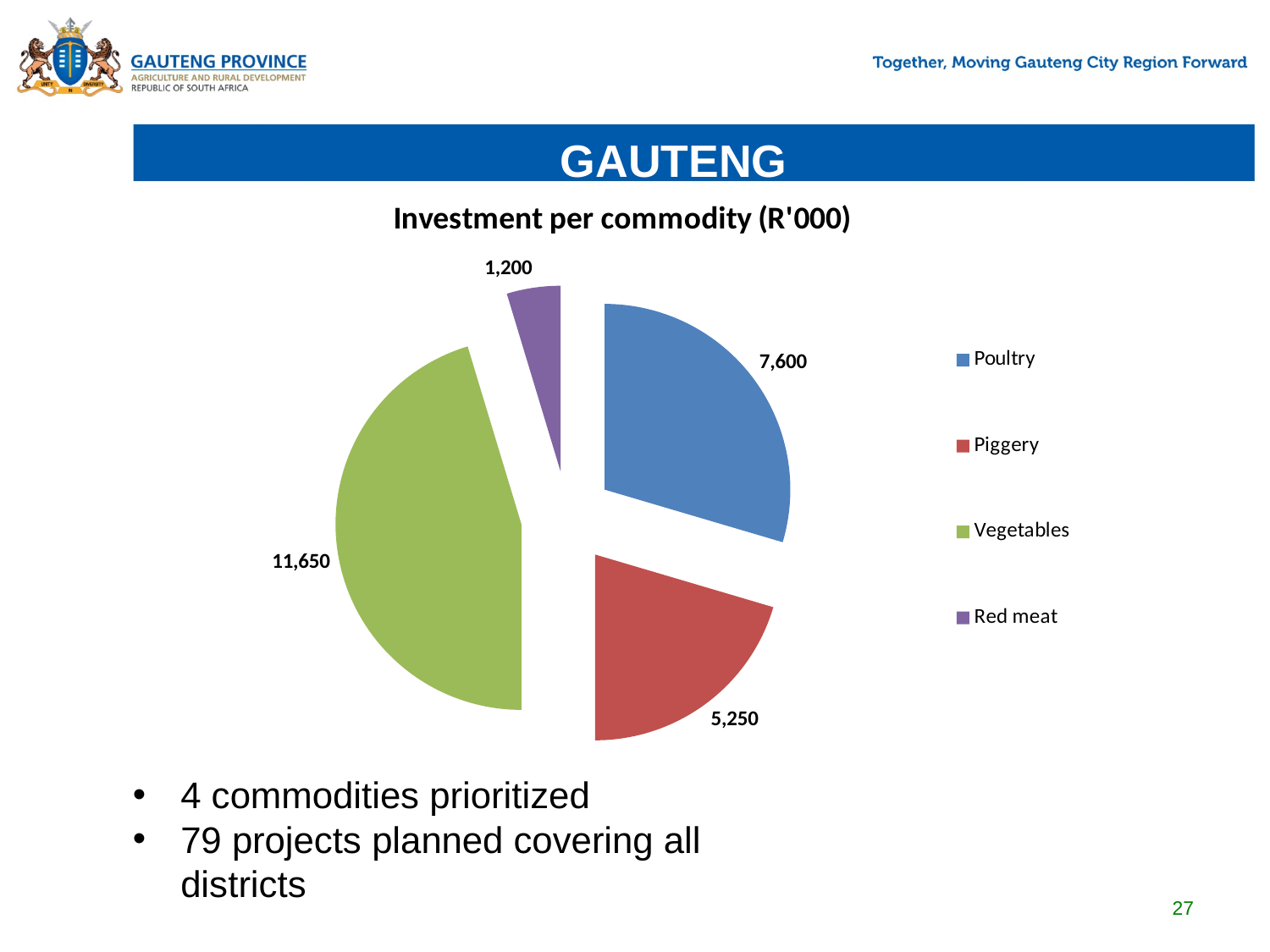
Which commodity has the largest investment? Vegetables What type of chart is shown on the slide? Pie chart Which has a larger investment, Poultry or Piggery? Poultry What is the title of the chart? Investment per commodity (R'000) What is the investment value for Vegetables? 11,650 What is the investment value for Red meat? 1,200 What is the total investment across all four commodities? 25,700 What is the investment value for Poultry? 7,600 What is the difference between the investment in Vegetables and the investment in Poultry? 4,050 What is the investment value for Piggery? 5,250 Which commodity has the smallest investment? Red meat How many commodities are shown in the pie chart? 4